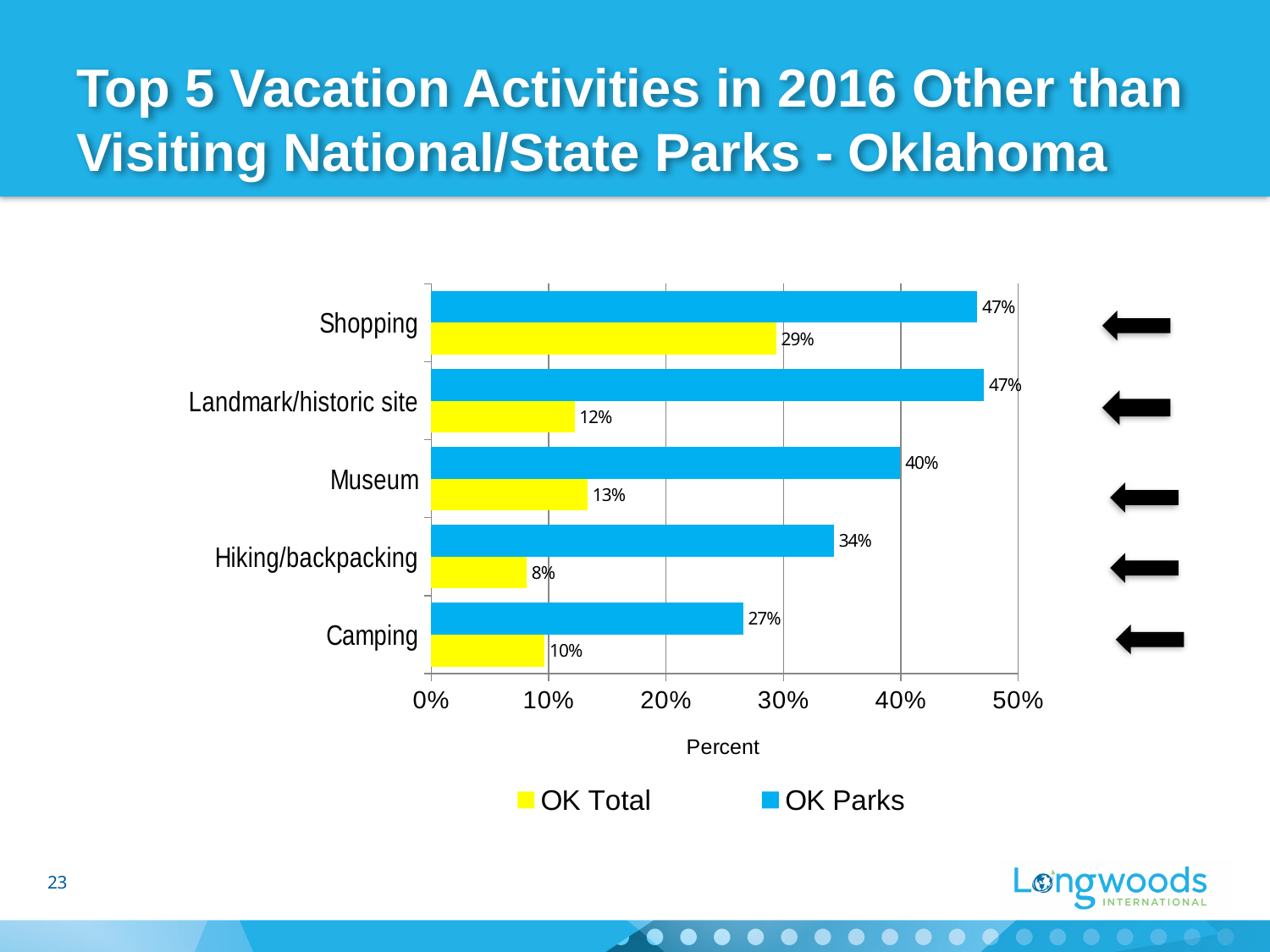
What is the difference between the OK Parks and OK Total values for Landmark/historic site? 35 percentage points What is the OK Parks value for Museum? 40% What is the OK Total value for Shopping? 29% How many activities are shown on the chart? 5 Which activity has the highest OK Total value? Shopping How many series does the legend list? 2 What is the OK Parks value for Hiking/backpacking? 34% Which activity has the lowest OK Total value? Hiking/backpacking What is the OK Total value for Camping? 10% What type of chart is shown on the slide? Bar chart Which activity has the lowest OK Parks value? Camping Which is larger for Museum: the OK Parks value or the OK Total value? OK Parks